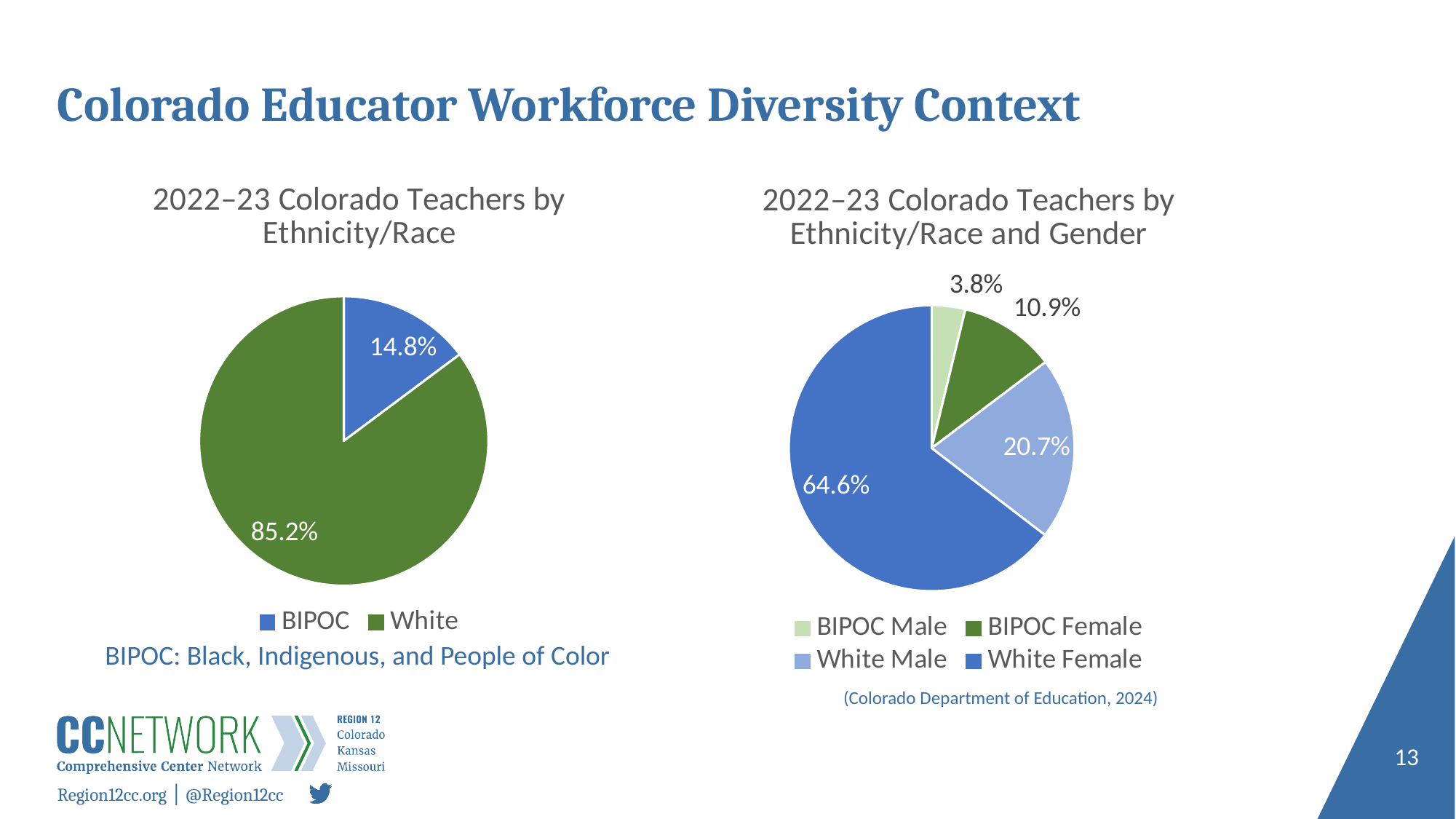
In the '2022–23 Colorado Teachers by Ethnicity/Race and Gender' chart, what is the value for BIPOC Male? 3.8% What type of chart is the '2022–23 Colorado Teachers by Ethnicity/Race' chart? Pie chart In the '2022–23 Colorado Teachers by Ethnicity/Race and Gender' chart, what is the value for White Male? 20.7% How many categories does the legend of the '2022–23 Colorado Teachers by Ethnicity/Race and Gender' chart list? 4 In the '2022–23 Colorado Teachers by Ethnicity/Race' chart, what share of teachers are BIPOC? 14.8% In the '2022–23 Colorado Teachers by Ethnicity/Race and Gender' chart, what is the difference between the White Male and BIPOC Female shares? 9.8% In the '2022–23 Colorado Teachers by Ethnicity/Race and Gender' chart, which category has the smallest slice? BIPOC Male In the '2022–23 Colorado Teachers by Ethnicity/Race and Gender' chart, which category has the largest slice? White Female In the '2022–23 Colorado Teachers by Ethnicity/Race' chart, what is the difference between the White and BIPOC shares? 70.4% In the '2022–23 Colorado Teachers by Ethnicity/Race and Gender' chart, what is the value for White Female? 64.6% In the '2022–23 Colorado Teachers by Ethnicity/Race and Gender' chart, which is larger, BIPOC Female or White Male? White Male In the '2022–23 Colorado Teachers by Ethnicity/Race' chart, what share of teachers are White? 85.2%